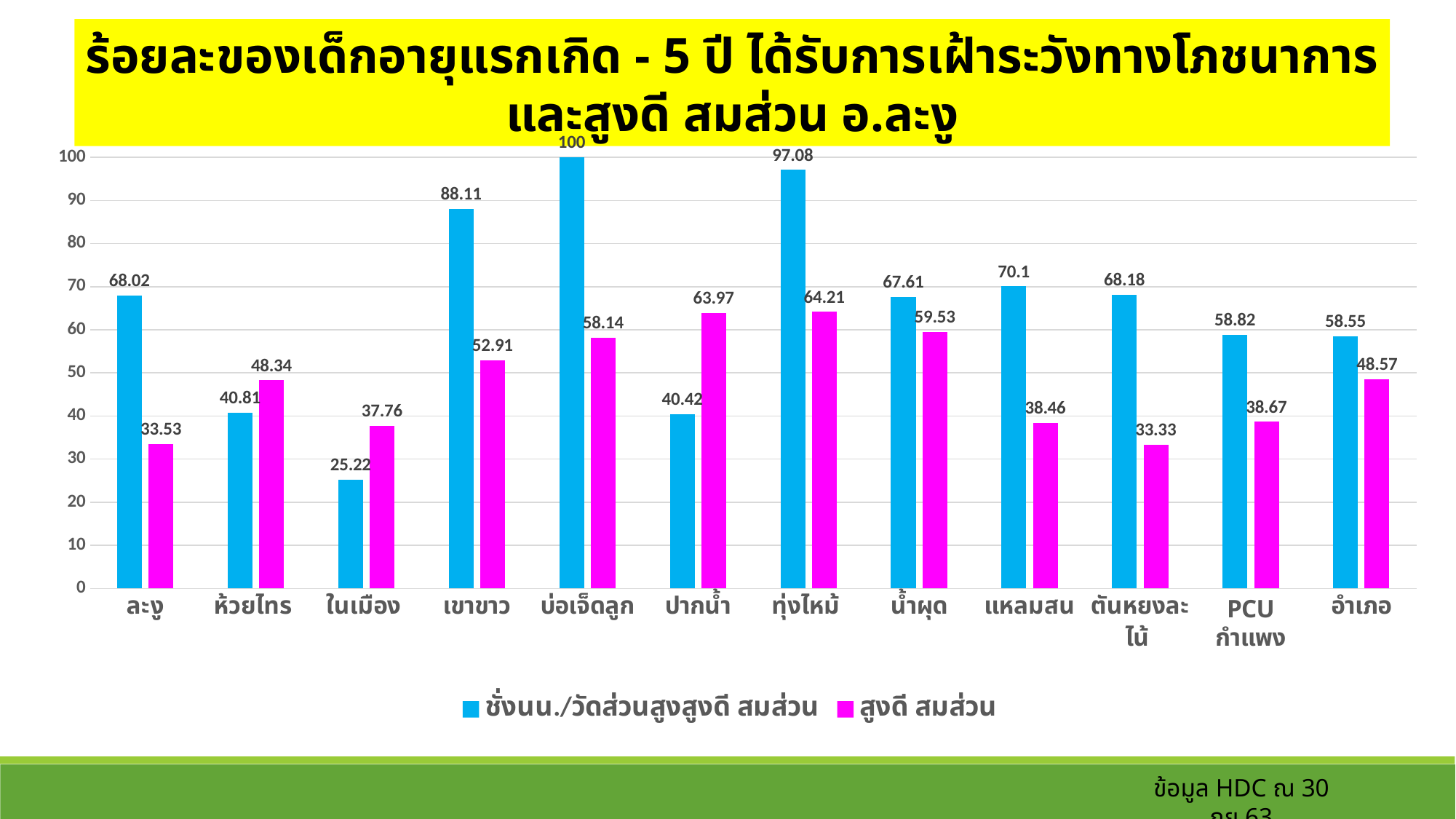
What is the value of สูงดี สมส่วน for ปากน้ำ? 63.97 What is the value of ชั่งนน./วัดส่วนสูงสูงดี สมส่วน for เขาขาว? 88.11 How many categories are shown on the x axis? 12 Which category has the lowest value for สูงดี สมส่วน? ตันหยงละไน้ How many series does the legend list? 2 Which category has the highest value for ชั่งนน./วัดส่วนสูงสูงดี สมส่วน? บ่อเจ็ดลูก Is the value of ชั่งนน./วัดส่วนสูงสูงดี สมส่วน for แหลมสน greater or less than 60? greater Which category has the lowest value for ชั่งนน./วัดส่วนสูงสูงดี สมส่วน? ในเมือง What type of chart is shown on the slide? bar chart What is the difference between the two series values for ทุ่งไหม้? 32.87 What colour are the bars for the series สูงดี สมส่วน? magenta For ห้วยไทร, which series has the larger value? สูงดี สมส่วน